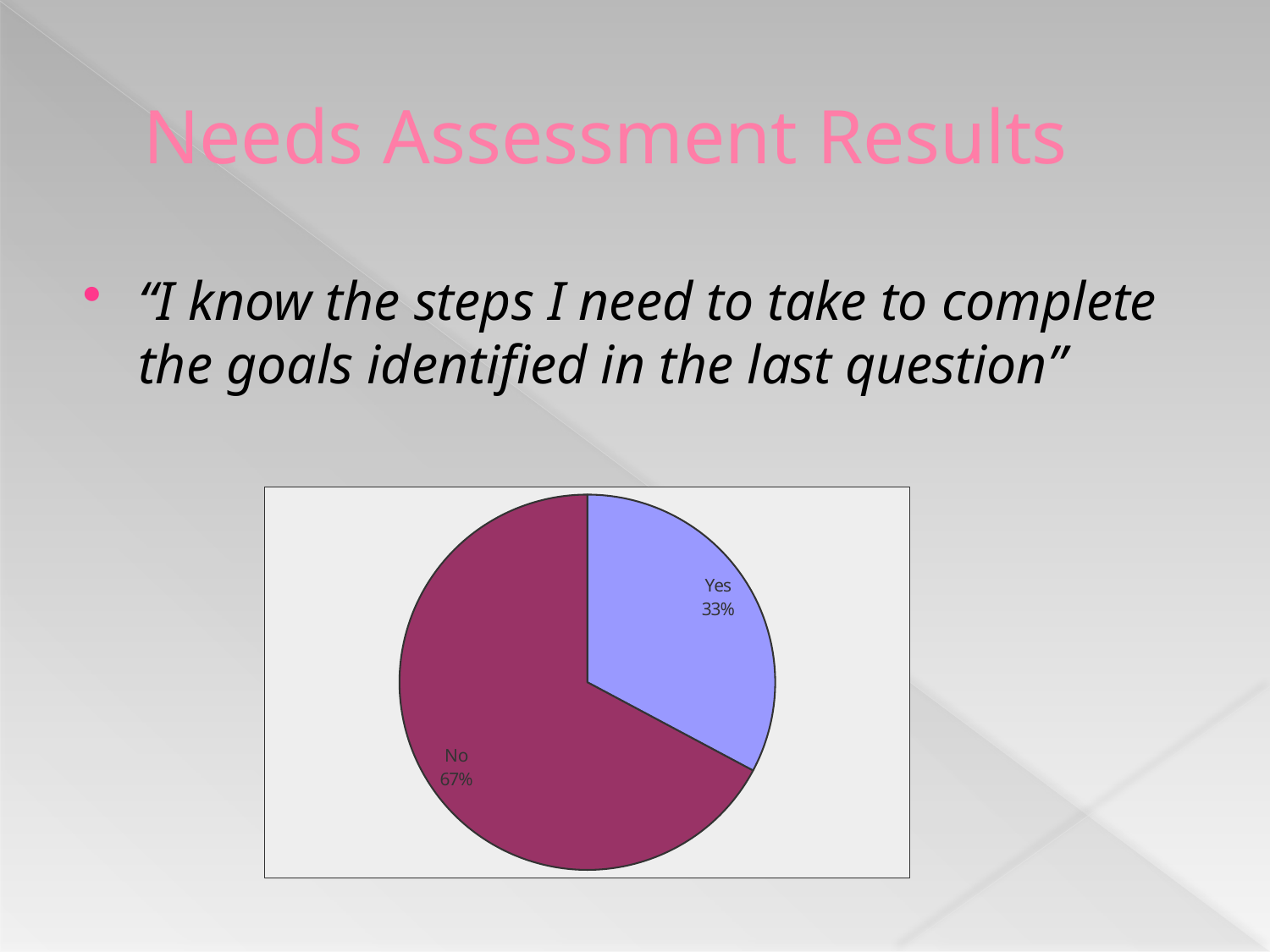
What share of the pie does the "No" slice represent? 67% What percentage of respondents answered "No"? 67% What is the difference in percentage points between the "No" and "Yes" slices? 34 Which response has the smallest share of the pie? Yes What percentage of respondents answered "Yes"? 33% Which is larger, the "Yes" slice or the "No" slice? No What kind of chart is shown on the slide? pie chart Which response has the largest share of the pie? No How many slices does the pie chart have? 2 What is the title of the slide containing the pie chart? Needs Assessment Results What colour is the "Yes" slice? light blue/purple